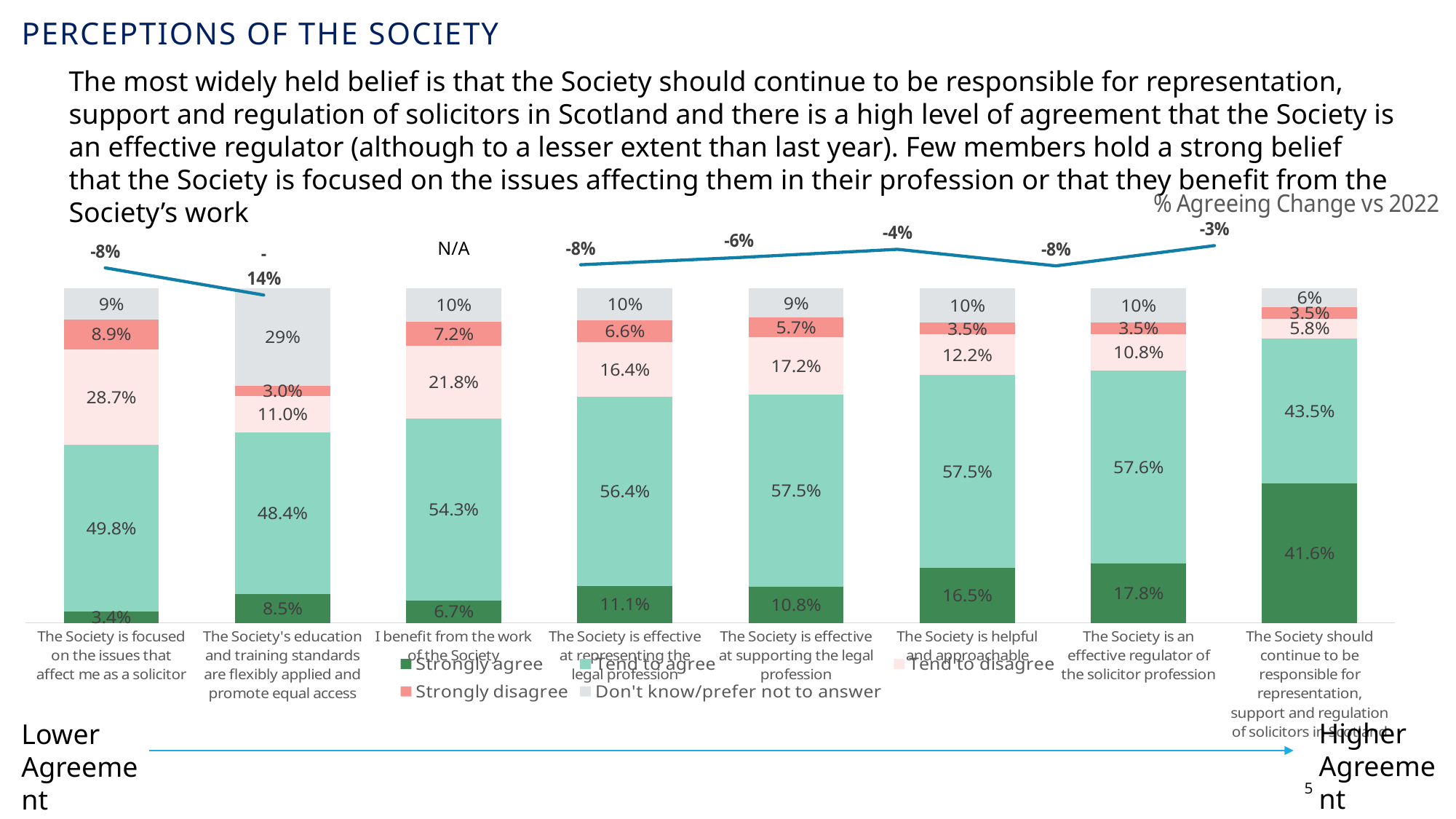
What kind of chart is shown on the slide? Stacked bar chart How many statements (categories) are plotted in the chart? 8 What percentage tend to agree that the Society is an effective regulator of the solicitor profession? 57.6% Which has a larger 'Tend to disagree' share: 'The Society is focused on the issues that affect me as a solicitor' or 'I benefit from the work of the Society'? The Society is focused on the issues that affect me as a solicitor How many series does the chart legend list? 5 What is the difference in 'Strongly agree' percentage between 'The Society is an effective regulator of the solicitor profession' and 'The Society is helpful and approachable'? 1.3 percentage points What is the '% Agreeing Change vs 2022' shown for 'The Society's education and training standards are flexibly applied and promote equal access'? -14% Which legend entry is shown in dark green? Strongly agree Which statement has the lowest 'Strongly agree' percentage? The Society is focused on the issues that affect me as a solicitor Which statement has the highest 'Strongly agree' percentage? The Society should continue to be responsible for representation, support and regulation of solicitors in Scotland What is the 'Don't know/prefer not to answer' share for the statement that the Society's education and training standards are flexibly applied and promote equal access? 29% What percentage of members strongly agree that the Society should continue to be responsible for representation, support and regulation of solicitors in Scotland? 41.6%